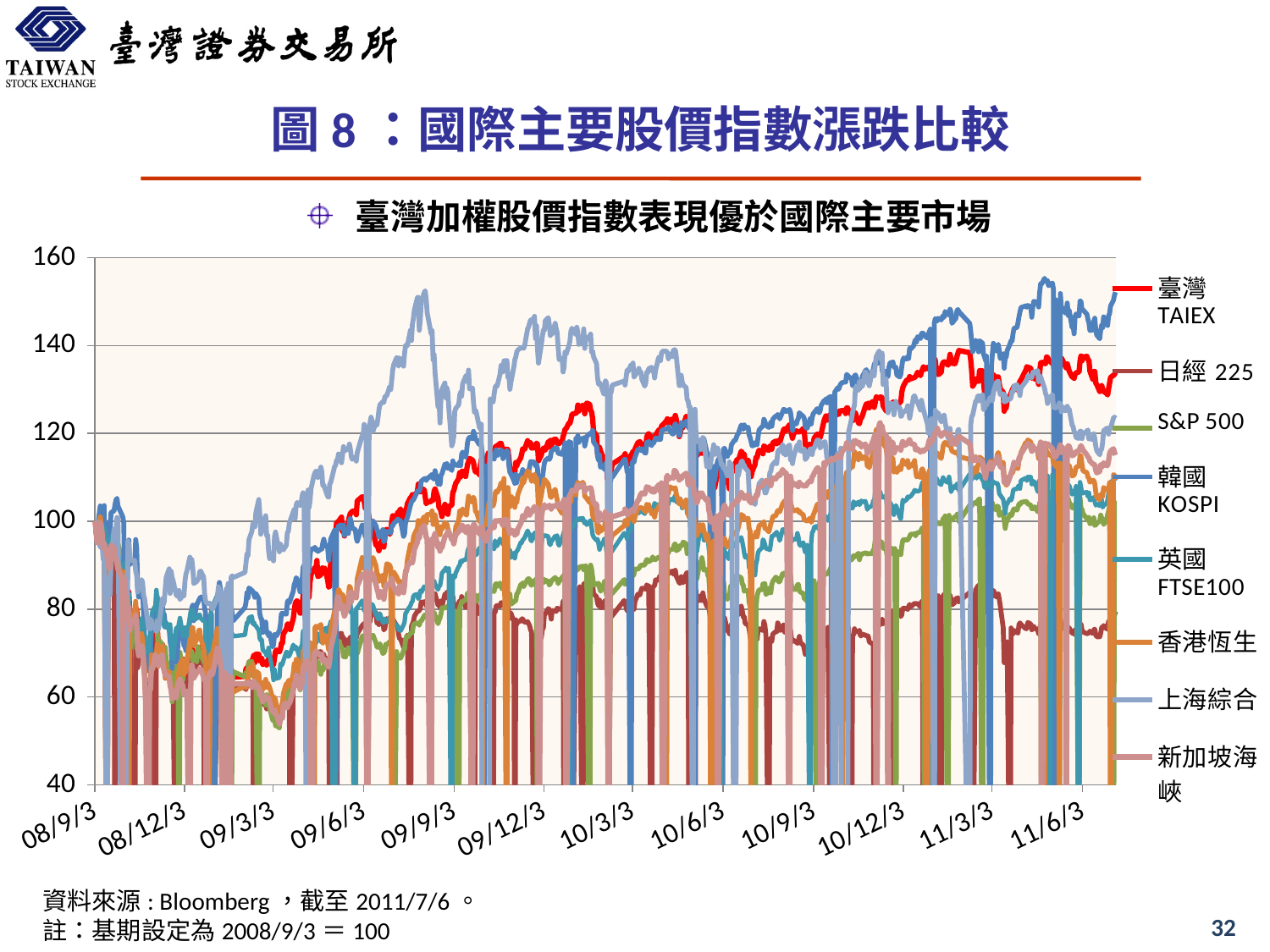
At the right end of the chart, is the value for 韓國 KOSPI greater or less than 140? greater At the right end of the chart, is the value for 日經 225 greater or less than 80? less At the right end of the chart, which is larger, 臺灣 TAIEX or 日經 225? 臺灣 TAIEX Does the 日經 225 line end higher or lower than where it started at 08/9/3? lower Which index has the highest value at the right end of the chart (around 11/6/3)? 韓國 KOSPI At the right end of the chart, is the value for 臺灣 TAIEX greater or less than 120? greater Which index has the lowest value at the right end of the chart (around 11/6/3)? 日經 225 What kind of chart is shown on the slide? line chart How many date labels are shown along the x axis? 12 What colour is the 臺灣 TAIEX line in the legend? red How many series does the legend list? 8 According to the note, what value are all indices set to at the base date 2008/9/3? 100